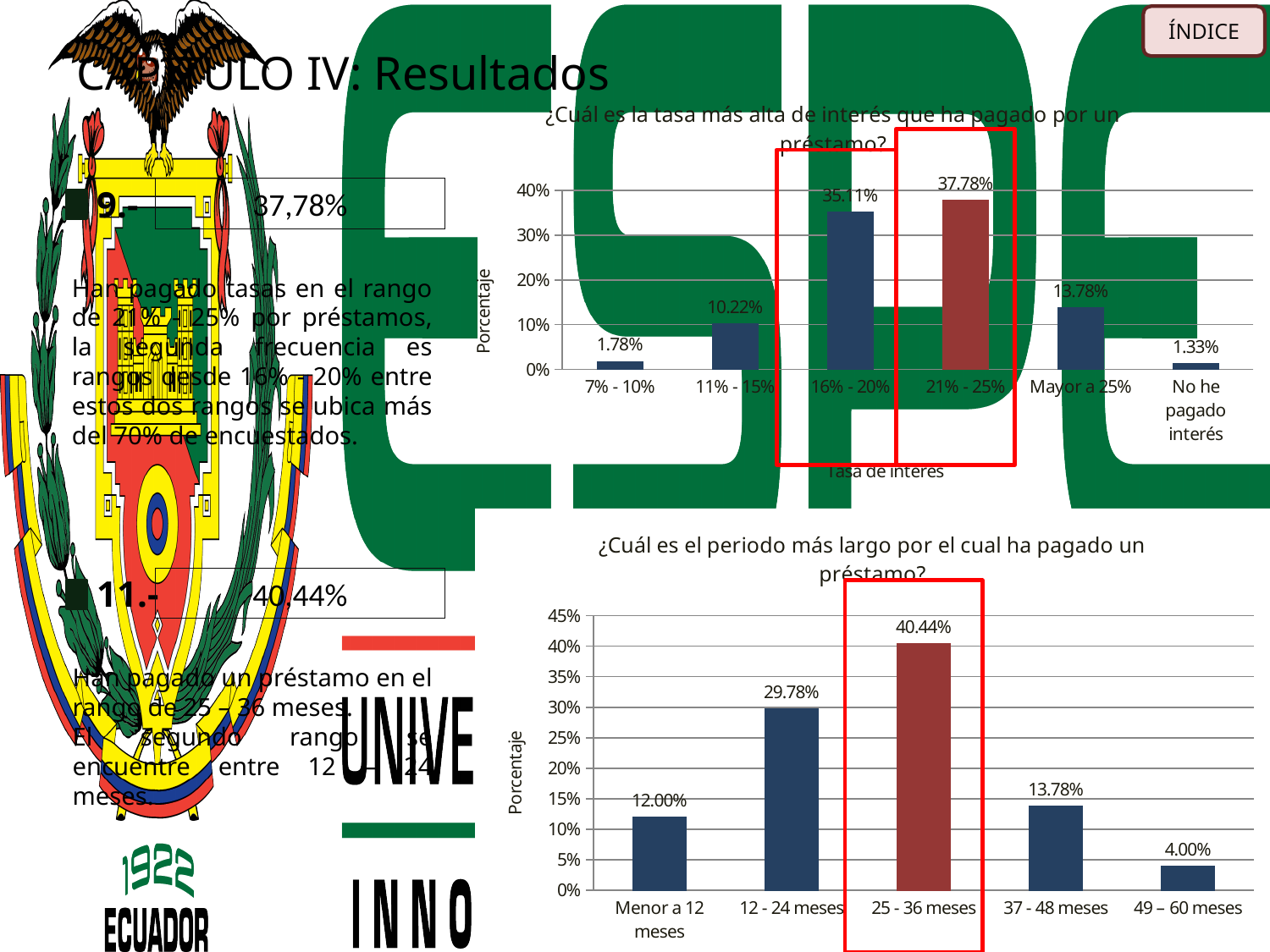
In the top chart (tasa más alta de interés), which category has the lowest value? No he pagado interés In the top chart (tasa más alta de interés), how many categories are shown on the x axis? 6 In the top chart (tasa más alta de interés), what is the difference between the 16% - 20% and 11% - 15% values? 24.89% In the top chart (tasa más alta de interés), what is the value for the 21% - 25% category? 37.78% In the bottom chart (periodo más largo), which category has the highest value? 25 - 36 meses What type of chart is the bottom chart (periodo más largo)? Bar chart In the bottom chart (periodo más largo), which is larger: Menor a 12 meses or 37 - 48 meses? 37 - 48 meses In the top chart (tasa más alta de interés), is the value for Mayor a 25% greater or less than 10%? greater In the bottom chart (periodo más largo), what is the value for 12 - 24 meses? 29.78% In the bottom chart (periodo más largo), how many categories are shown on the x axis? 5 In the top chart (tasa más alta de interés), what is the value for the 11% - 15% category? 10.22% In the bottom chart (periodo más largo), what is the difference between the 25 - 36 meses and 49 – 60 meses values? 36.44%